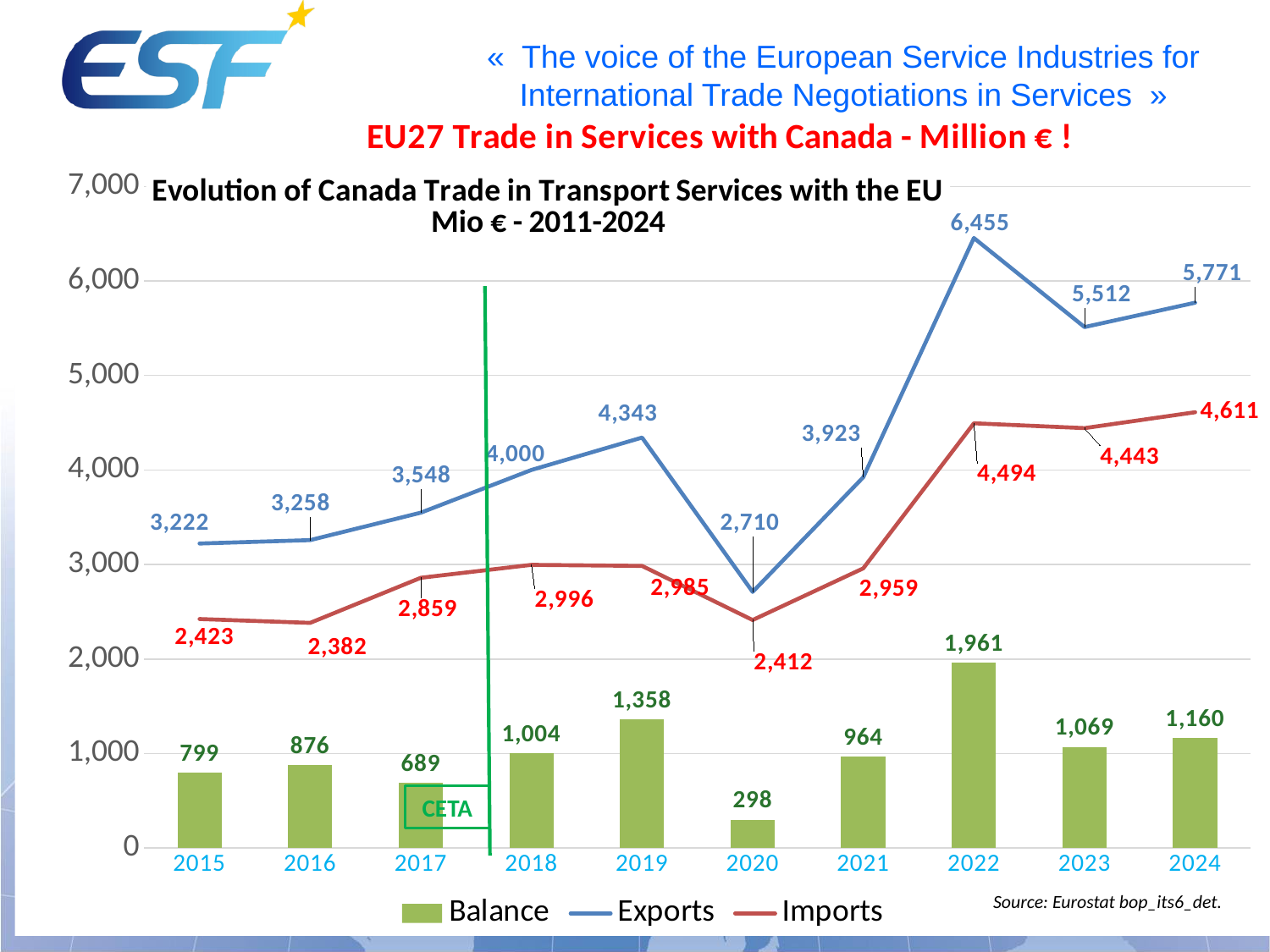
In which year are Exports highest? 2022 In which year is the Balance bar lowest? 2020 Do Exports rise or fall from 2019 to 2020? fall How many years are shown on the x axis? 10 How many series does the legend list? 3 What is the Exports value for 2022? 6,455 Which is larger in 2023: Exports or Imports? Exports Which series is shown as green bars? Balance What is the Imports value for 2016? 2,382 Is the Imports value for 2022 greater or less than 4,000? greater What is the difference between Exports and Imports in 2024? 1,160 What is the Balance value for 2019? 1,358